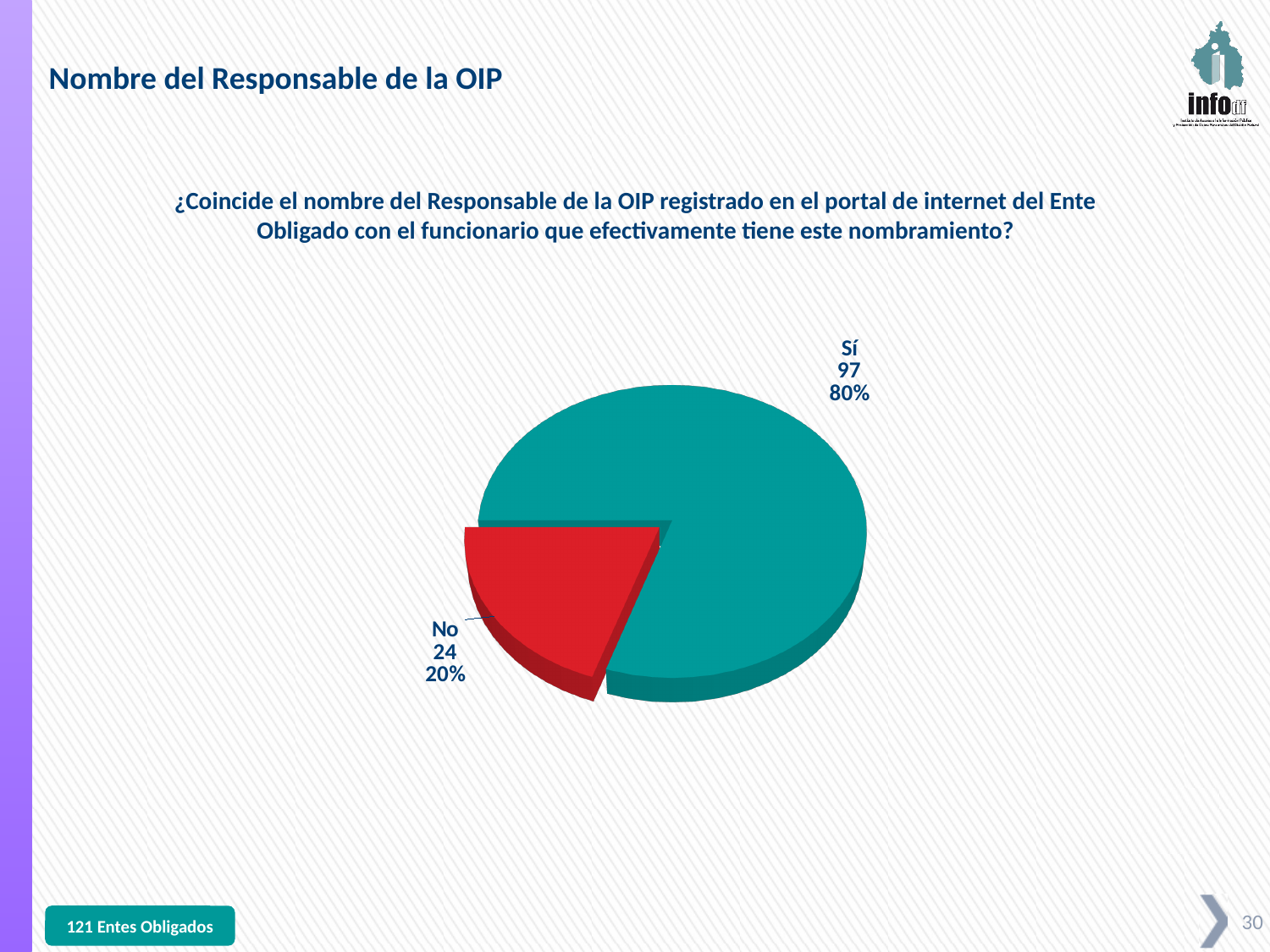
Which slice is the smallest? No What share of the pie does the "Sí" slice represent? 80% How many slices does the pie chart have? 2 Which slice is the largest? Sí What share of the pie does the "No" slice represent? 20% What kind of chart is shown on the slide? pie chart What is the value for the "Sí" slice? 97 What is the difference between the "Sí" and "No" values? 73 What is the total of the two slices in the pie chart? 121 What colour is the "No" slice? red What is the value for the "No" slice? 24 Which is larger, the "Sí" slice or the "No" slice? Sí